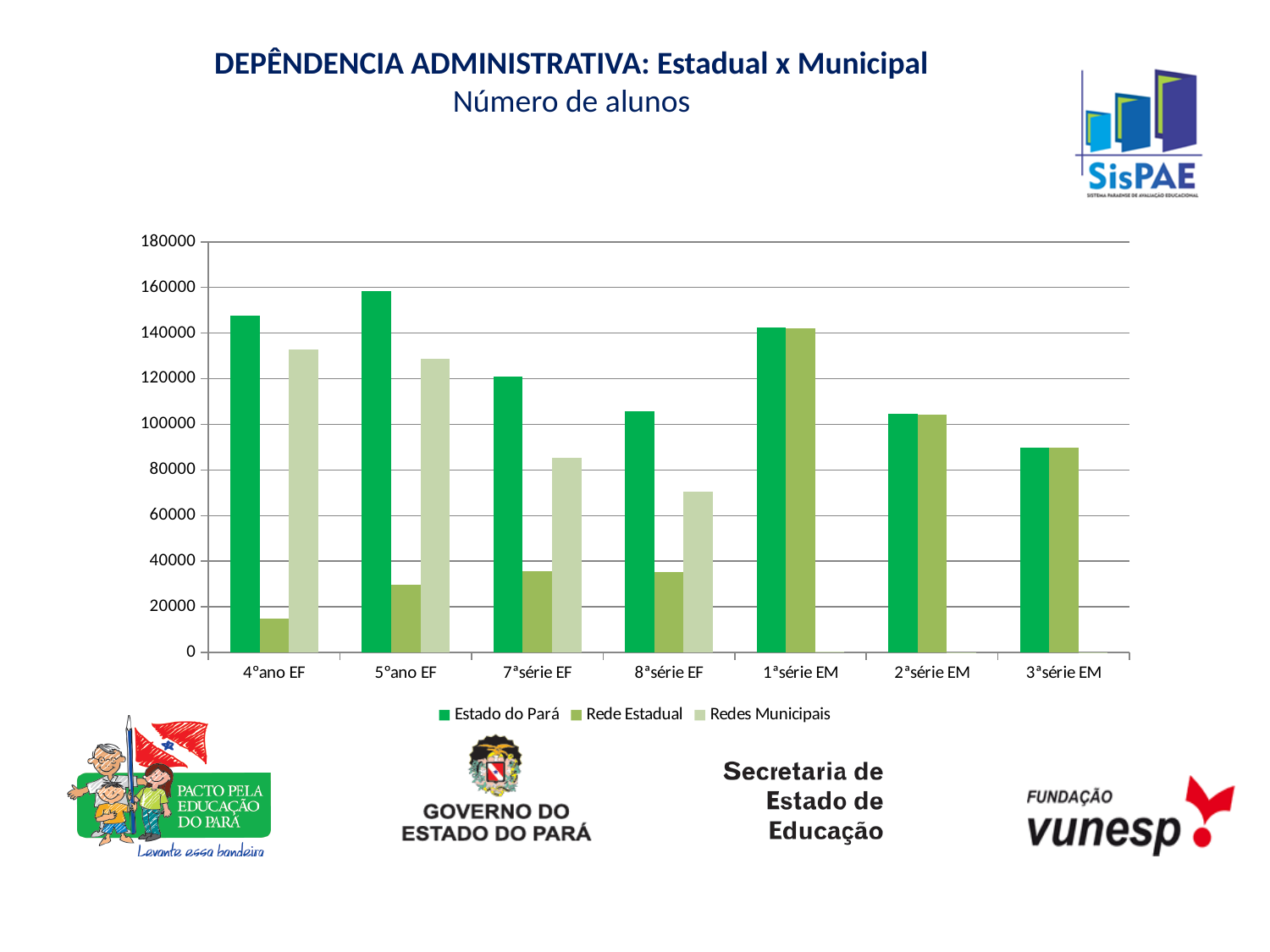
At 7ªsérie EF, which is larger: Rede Estadual or Redes Municipais? Redes Municipais Which category has the highest value for Rede Estadual? 1ªsérie EM Do the Redes Municipais values rise or fall from 4°ano EF to 8ªsérie EF? fall What kind of chart is shown on the slide? bar chart How many categories are shown on the x axis? 7 How many series does the legend list? 3 Which category has the highest value for Estado do Pará? 5°ano EF Is the value for Redes Municipais at 8ªsérie EF greater or less than 80000? less Is the value for Estado do Pará at 5°ano EF greater or less than 140000? greater Which category has the lowest value for Rede Estadual? 4°ano EF Is the value for Rede Estadual at 4°ano EF greater or less than 20000? less Which category has the lowest value for Estado do Pará? 3ªsérie EM